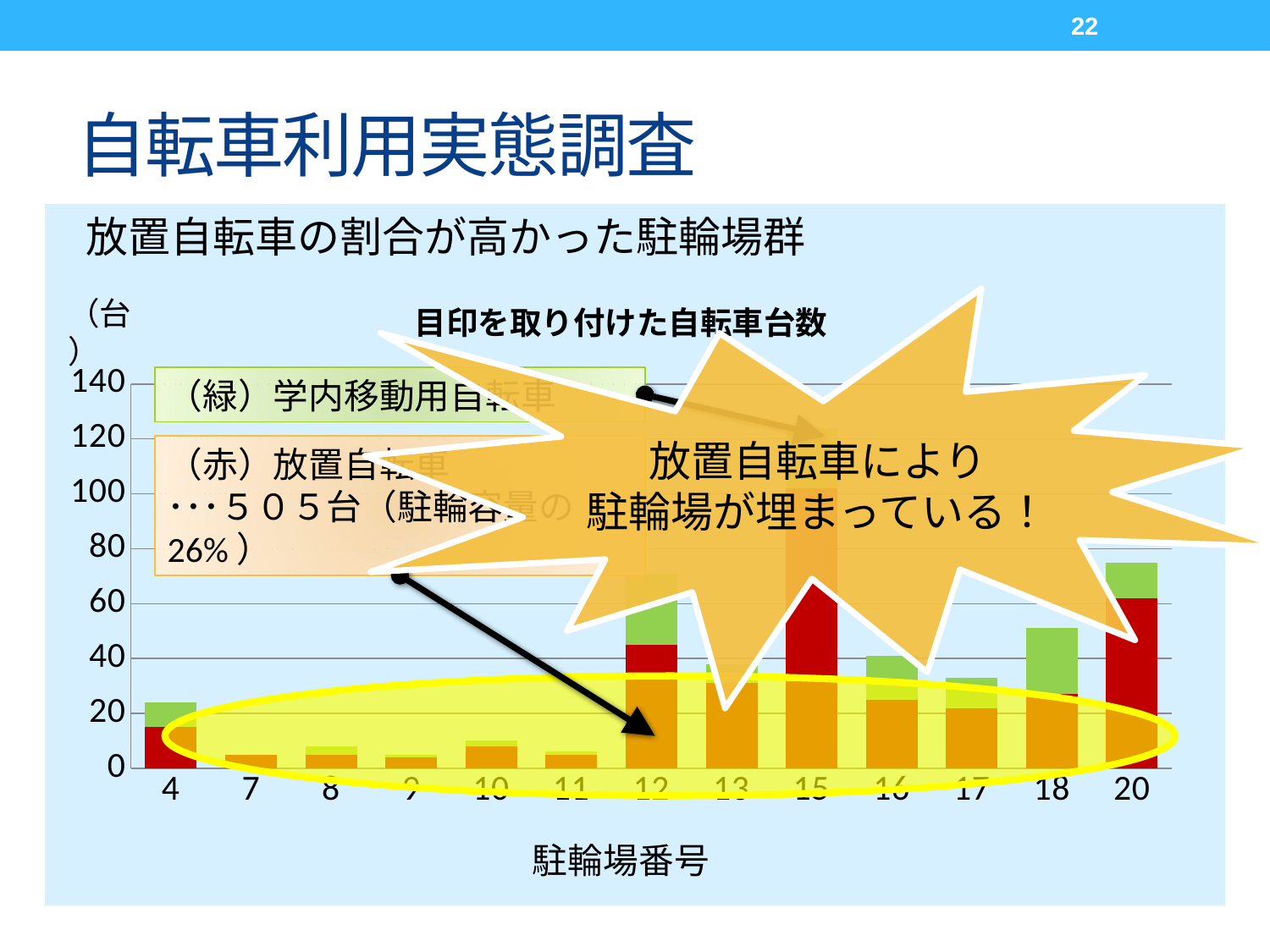
What kind of chart is shown on the slide? stacked bar chart Which has a larger total value, parking lot 12 or parking lot 16? 12 What is the title of the chart? 目印を取り付けた自転車台数 Is the total value for parking lot 17 greater or less than 40? less Which has a larger total value, parking lot 18 or parking lot 17? 18 How many parking lot numbers (categories) are shown on the x axis of the chart? 13 Which has a larger total value, parking lot 20 or parking lot 4? 20 What is the x-axis title of the chart? 駐輪場番号 Is the total value for parking lot 7 greater or less than 20? less Is the total value for parking lot 18 greater or less than 40? greater